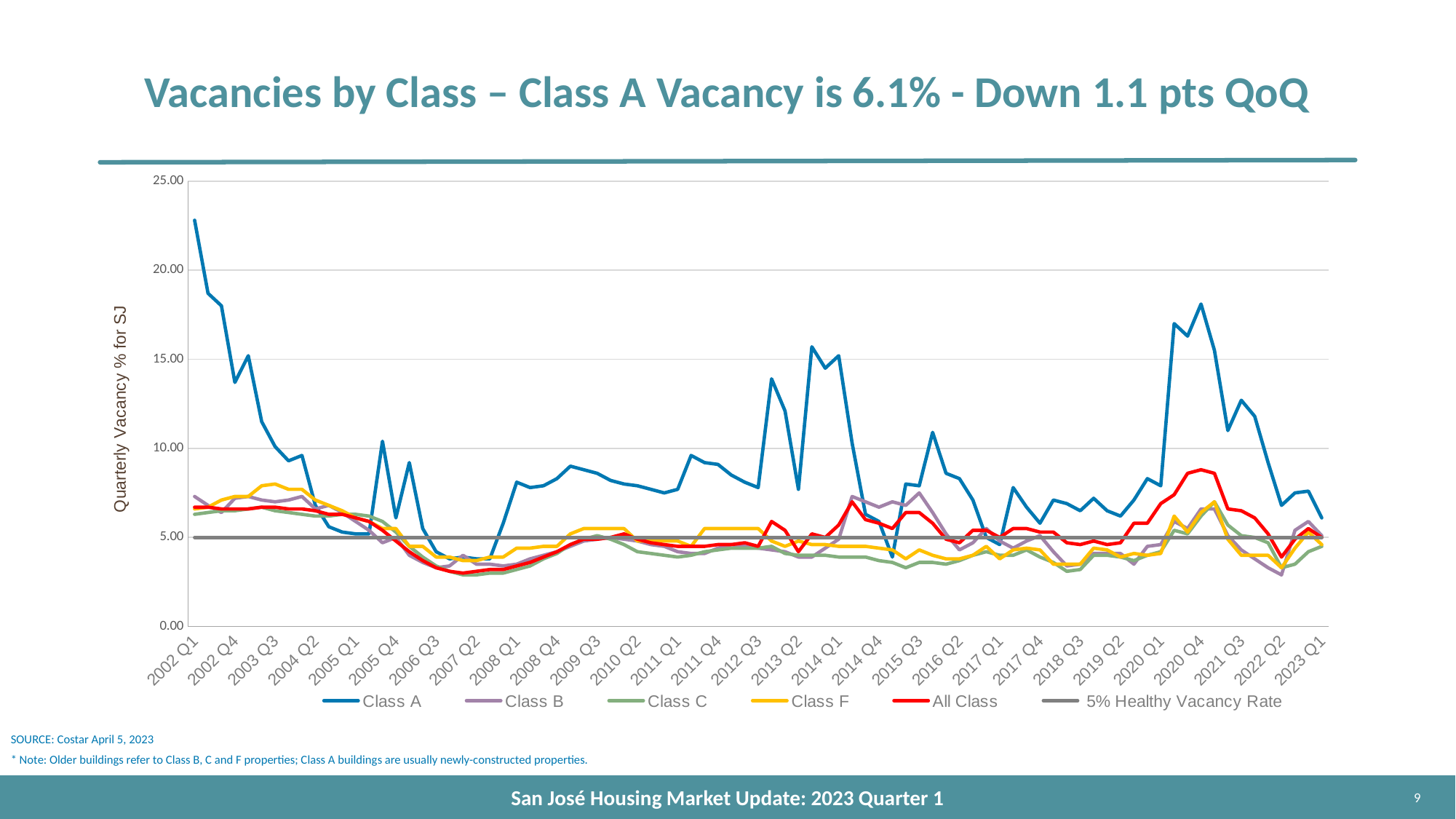
Is the Class B value at 2022 Q2 greater or less than 5.00? less According to the slide title, what is the Class A vacancy rate in 2023 Q1? 6.1% Is the Class A value at 2020 Q4 greater or less than 15.00? greater At 2020 Q4, which is larger: Class A or All Class? Class A Which series has the highest value at 2002 Q1? Class A What vacancy rate does the grey horizontal reference line represent? 5% Healthy Vacancy Rate Does the Class A line rise or fall from 2002 Q1 to 2004 Q2? fall What is the label on the vertical axis of the chart? Quarterly Vacancy % for SJ What kind of chart is shown on the slide? line chart Is the All Class value at 2020 Q4 greater or less than 10.00? less How many series does the chart legend list? 6